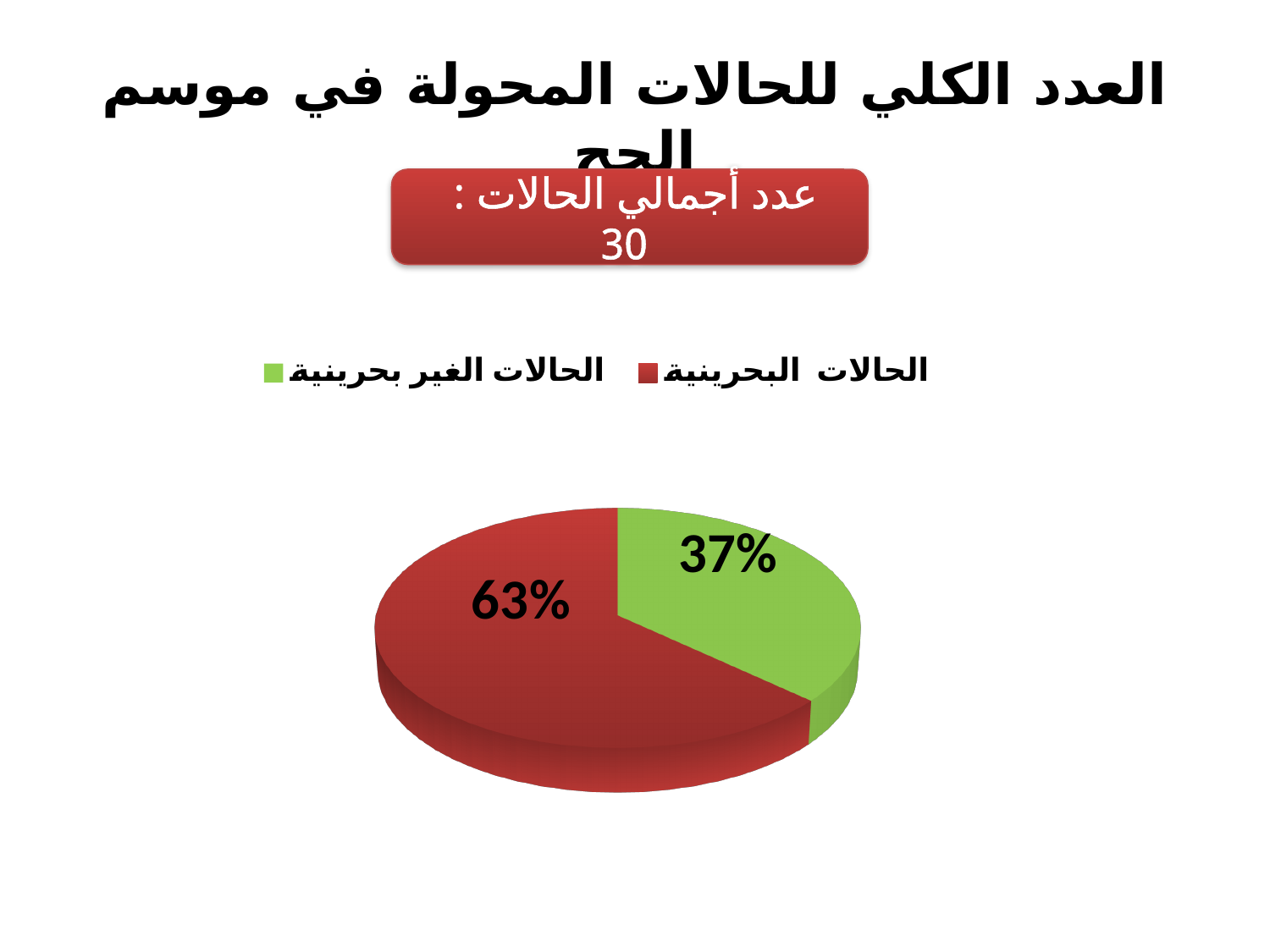
What total number of cases is stated in the red box above the chart? 30 What share of the pie does the slice for الحالات الغير بحرينية (the green slice) represent? 37% Which is larger: the share for الحالات البحرينية or the share for الحالات الغير بحرينية? الحالات البحرينية What kind of chart is shown on the slide? pie chart What colour is the slice for الحالات الغير بحرينية? green Which category has the largest slice of the pie? الحالات البحرينية Which category has the smallest slice of the pie? الحالات الغير بحرينية What share of the pie does the slice for الحالات البحرينية (the red slice) represent? 63% How many entries does the legend list? 2 What is the difference in percentage points between the الحالات البحرينية slice and the الحالات الغير بحرينية slice? 26 percentage points How many slices does the pie chart have? 2